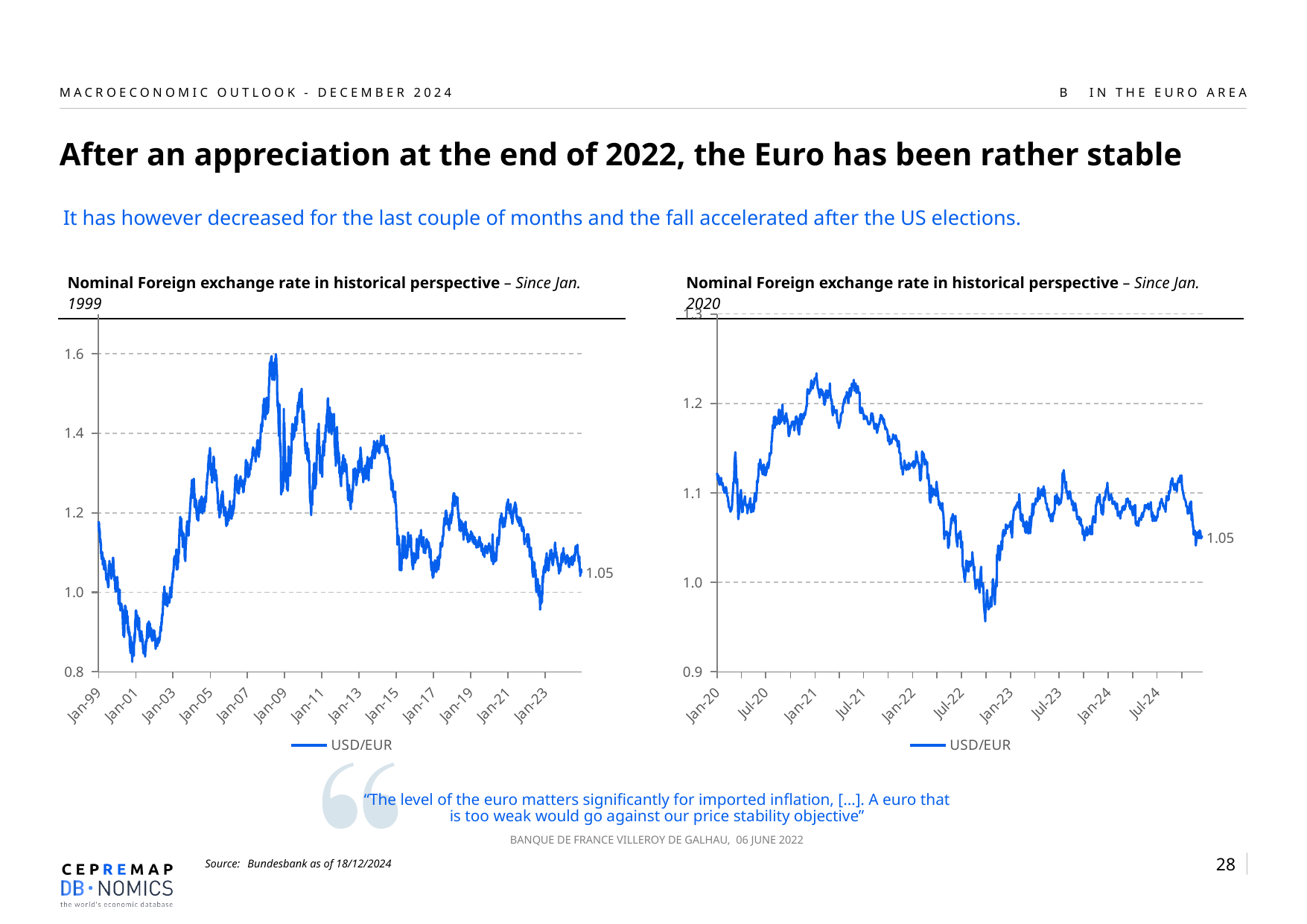
What series name appears in the legend of the right chart (since Jan. 2020)? USD/EUR In the left chart (since Jan. 1999), is the USD/EUR value around Jan-01 greater or less than 1.0? less In the right chart (since Jan. 2020), is the lowest USD/EUR value, reached in late 2022, greater or less than 1.0? less In the right chart (since Jan. 2020), what is the latest USD/EUR value labelled at the end of the line? 1.05 In the left chart (since Jan. 1999), is the USD/EUR value around Jan-09 higher or lower than the value around Jan-01? Higher In the right chart (since Jan. 2020), is the USD/EUR value around Jan-21 greater or less than 1.1? greater In the right chart (since Jan. 2020), does the USD/EUR rate rise or fall between Jan-21 and Jul-22? Fall In the left chart (since Jan. 1999), what is the latest USD/EUR value labelled at the end of the line? 1.05 What kind of chart is the right chart, 'Nominal Foreign exchange rate in historical perspective – Since Jan. 2020'? Line chart How many series does the legend of the left chart (since Jan. 1999) list? 1 What kind of chart is the left chart, 'Nominal Foreign exchange rate in historical perspective – Since Jan. 1999'? Line chart